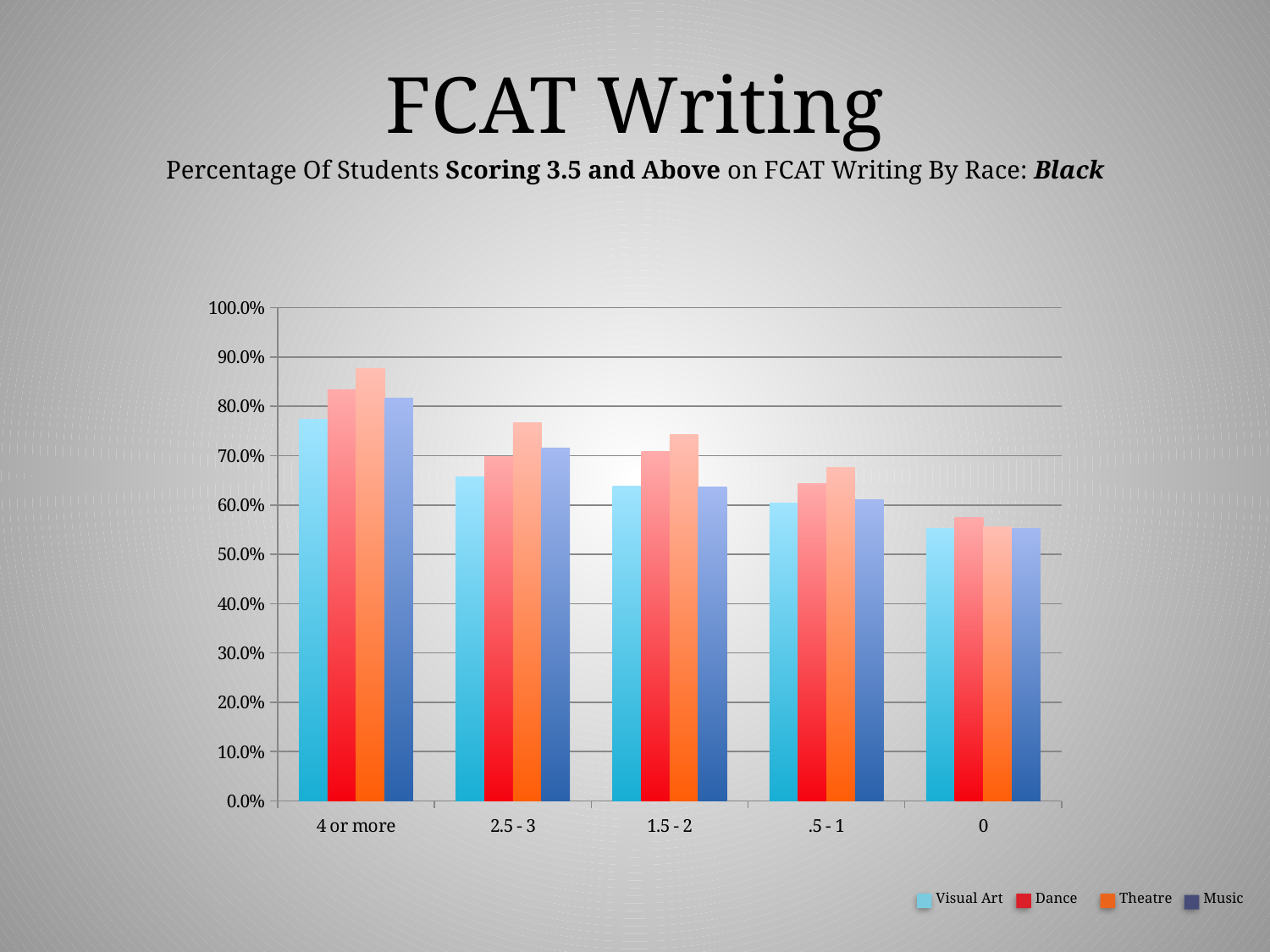
Is the Dance value for ".5 - 1" greater or less than 70.0%? less In the "1.5 - 2" category, which is larger: Dance or Music? Dance Is the Theatre value for "4 or more" greater or less than 80.0%? greater How many series does the chart's legend list? 4 What are the four series listed in the chart's legend? Visual Art, Dance, Theatre, Music For the Theatre series, which category has the lowest value? 0 How many categories are shown along the x axis of the chart? 5 What kind of chart is shown on the slide? bar chart Is the Visual Art value for "0" greater or less than 60.0%? less Which series has the highest value in the "4 or more" category? Theatre Do the Theatre values rise or fall moving from "4 or more" to "0" along the x axis? fall In the "2.5 - 3" category, which is larger: Theatre or Visual Art? Theatre